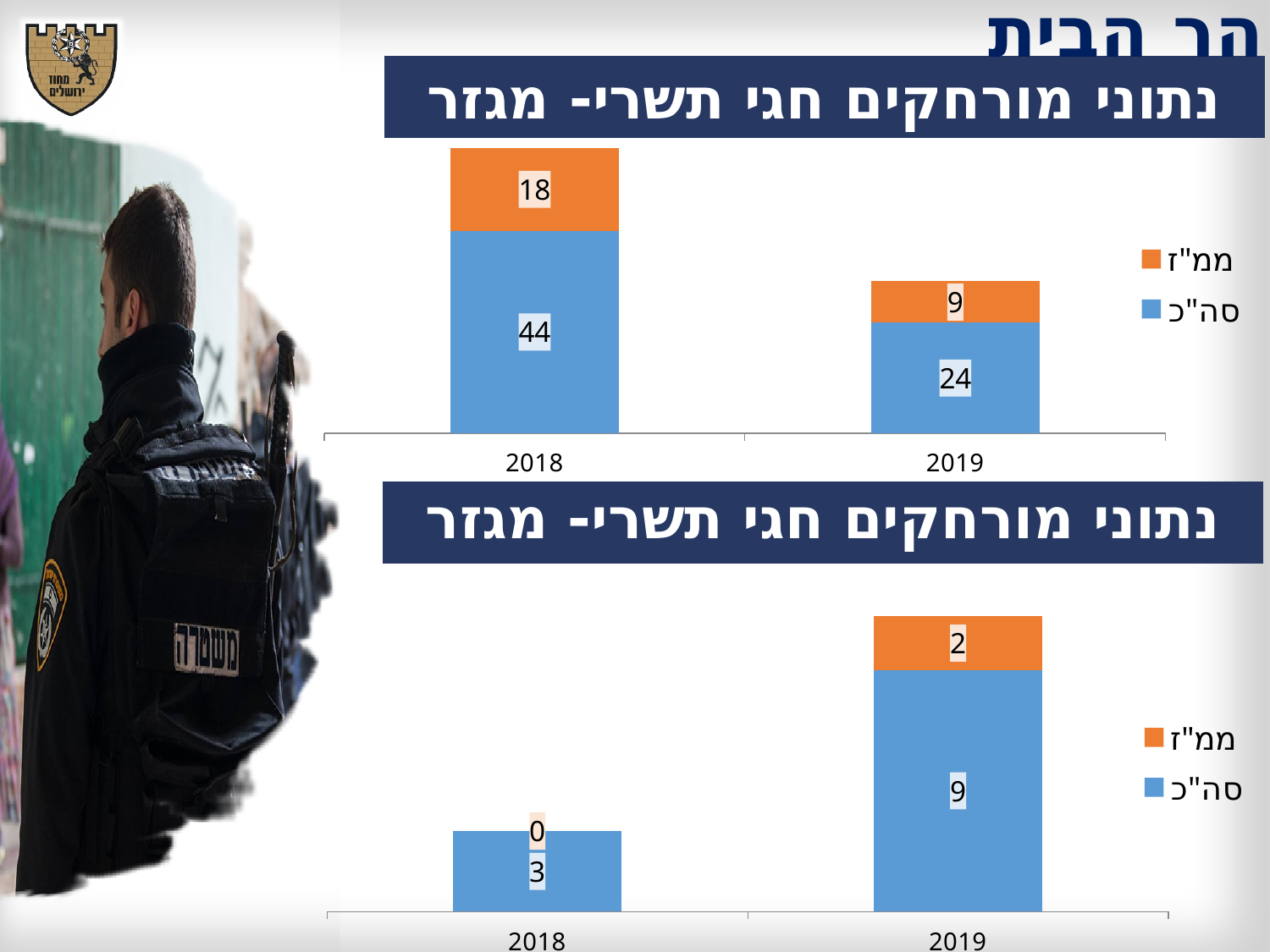
In the bottom chart, what is the total of the stacked bar for 2019? 11 In the top chart, what is the value of סה"כ for 2018? 44 In the top chart, what is the value of ממ"ז for 2019? 9 In the top chart, what is the difference between the סה"כ values for 2018 and 2019? 20 In the bottom chart, what is the value of ממ"ז for 2018? 0 In the bottom chart, what is the value of סה"כ for 2019? 9 In the top chart, which year has the higher ממ"ז value? 2018 In the top chart, what is the total of the stacked bar for 2018? 62 In the top chart, what is the total of the stacked bar for 2019? 33 In the bottom chart, which year has the higher סה"כ value? 2019 What kind of chart is the bottom chart? Stacked bar chart How many series does the legend of the top chart list? 2